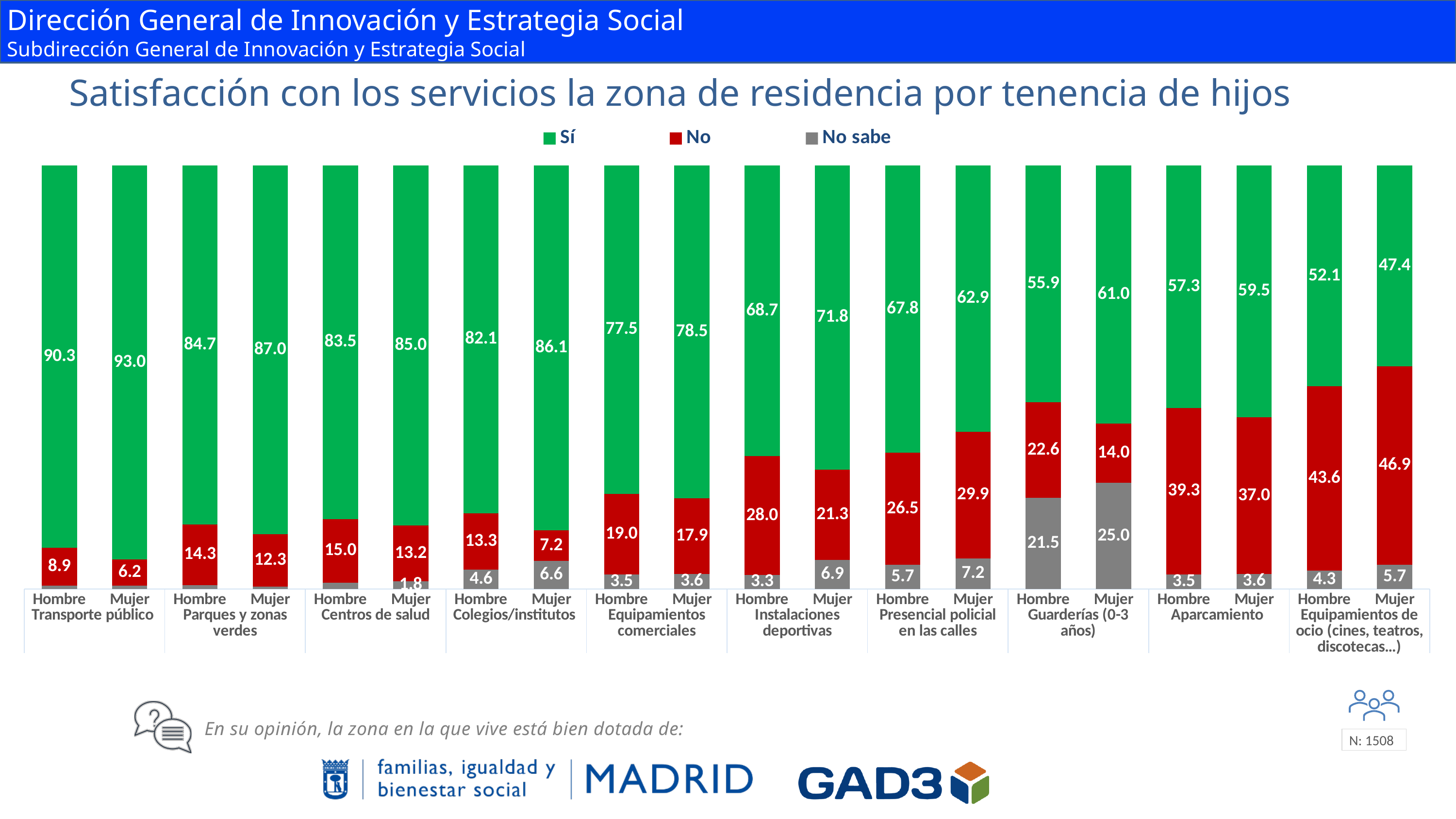
What is the 'Sí' value for Mujer in Transporte público? 93.0 Which bar has the lowest 'Sí' value? Mujer, Equipamientos de ocio (47.4) Which has a larger 'No' value in Aparcamiento, Hombre or Mujer? Hombre Which bar has the highest 'No' value? Mujer, Equipamientos de ocio (46.9) What kind of chart is shown on the slide? Stacked bar chart What is the difference between the 'No' values for Mujer and Hombre in Presencial policial en las calles? 3.4 Which bar has the highest 'Sí' value? Mujer, Transporte público (93.0) What is the 'No' value for Hombre in Guarderías (0-3 años)? 22.6 How many series does the legend list? 3 What is the difference between the 'Sí' values for Mujer and Hombre in Instalaciones deportivas? 3.1 What is the total of the stacked bar for Hombre in Guarderías (0-3 años)? 100.0 What is the 'No sabe' value for Mujer in Guarderías (0-3 años)? 25.0